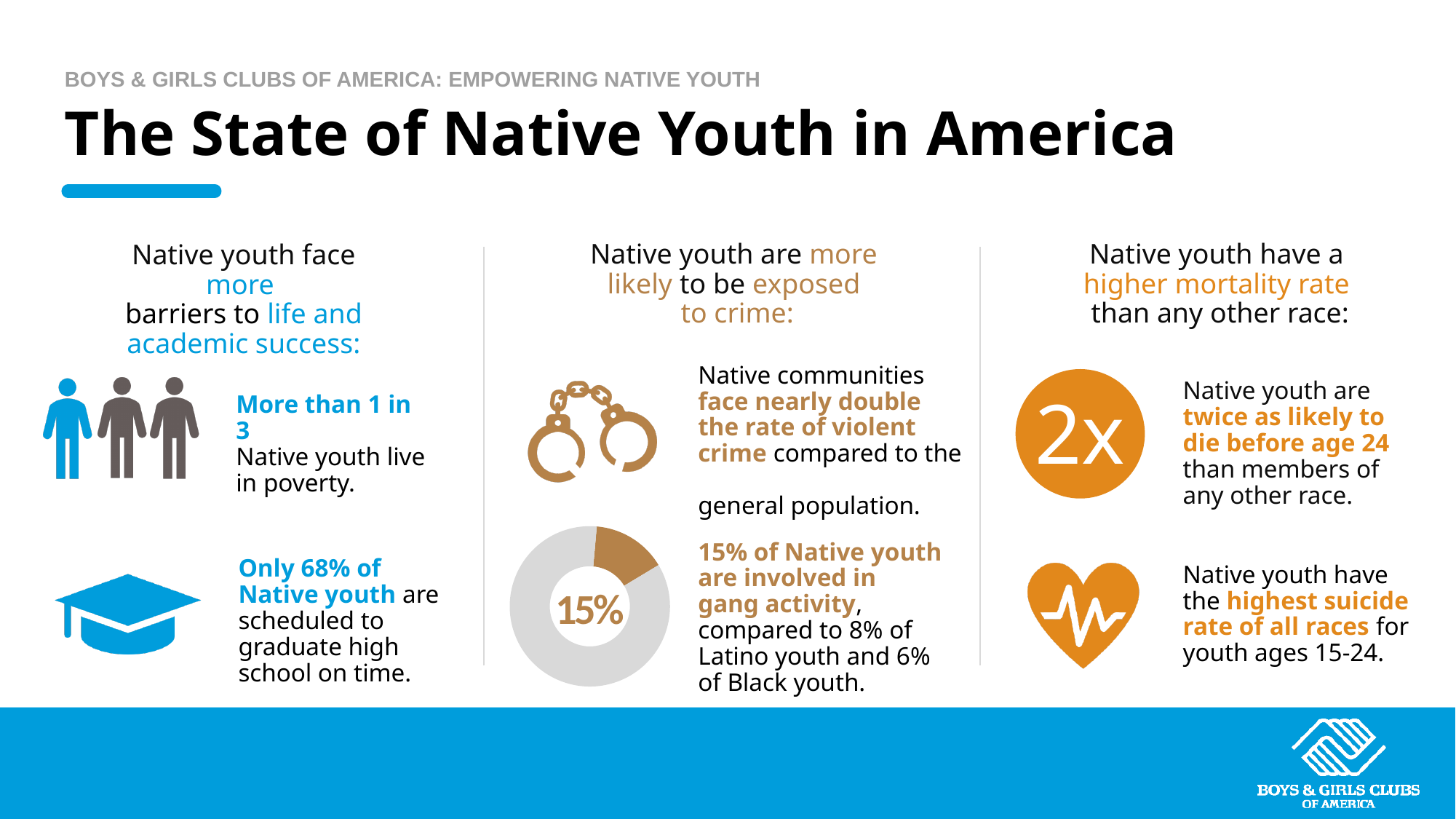
Is the highlighted slice of the doughnut chart greater or less than 50% of the whole? less According to the text beside the doughnut chart, what does the 15% slice represent? Native youth involved in gang activity What kind of chart is shown in the middle column of the slide? doughnut chart What percentage is printed in the centre of the doughnut chart? 15% Is the highlighted slice of the doughnut chart greater or less than 25% of the whole? less What colour is the highlighted 15% slice of the doughnut chart? brown What share of the doughnut chart is not highlighted (the grey portion)? 85% In the doughnut chart, which segment is larger: the highlighted 15% slice or the grey remainder? the grey remainder How many distinct segments does the doughnut chart show? 2 What share of the doughnut chart does the highlighted (brown) slice represent? 15%